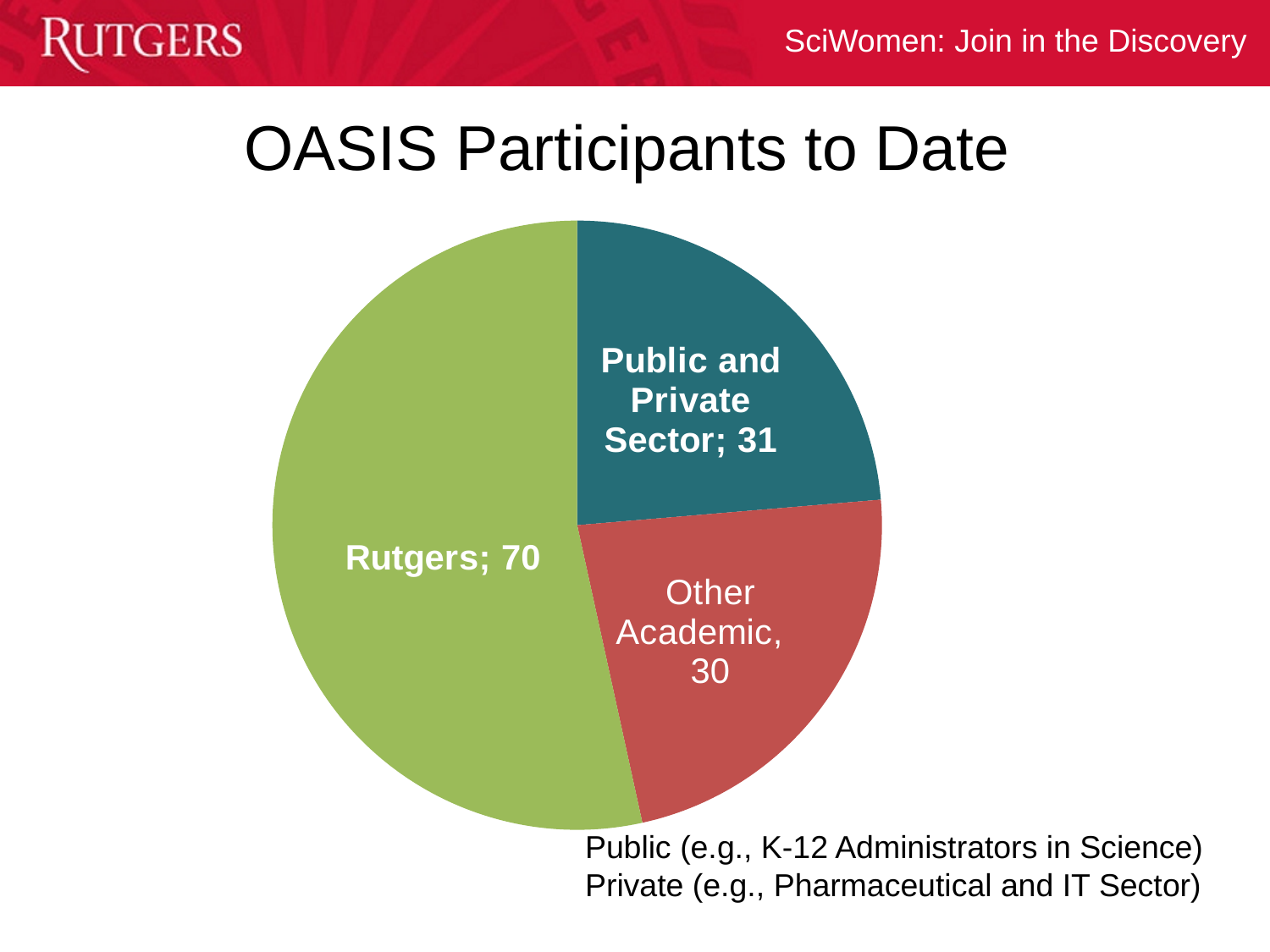
What is the value for Rutgers? 70 What is the difference between the Rutgers value and the Other Academic value? 40 What is the difference between the Public and Private Sector value and the Other Academic value? 1 What is the total of all three slices? 131 What is the title of the chart? OASIS Participants to Date How many slices does the pie chart have? 3 What is the value for Public and Private Sector? 31 What type of chart is shown on the slide? pie chart Which category has the largest slice? Rutgers Which is larger, the value for Rutgers or the value for Public and Private Sector? Rutgers Which category has the smallest value? Other Academic What is the value for Other Academic? 30